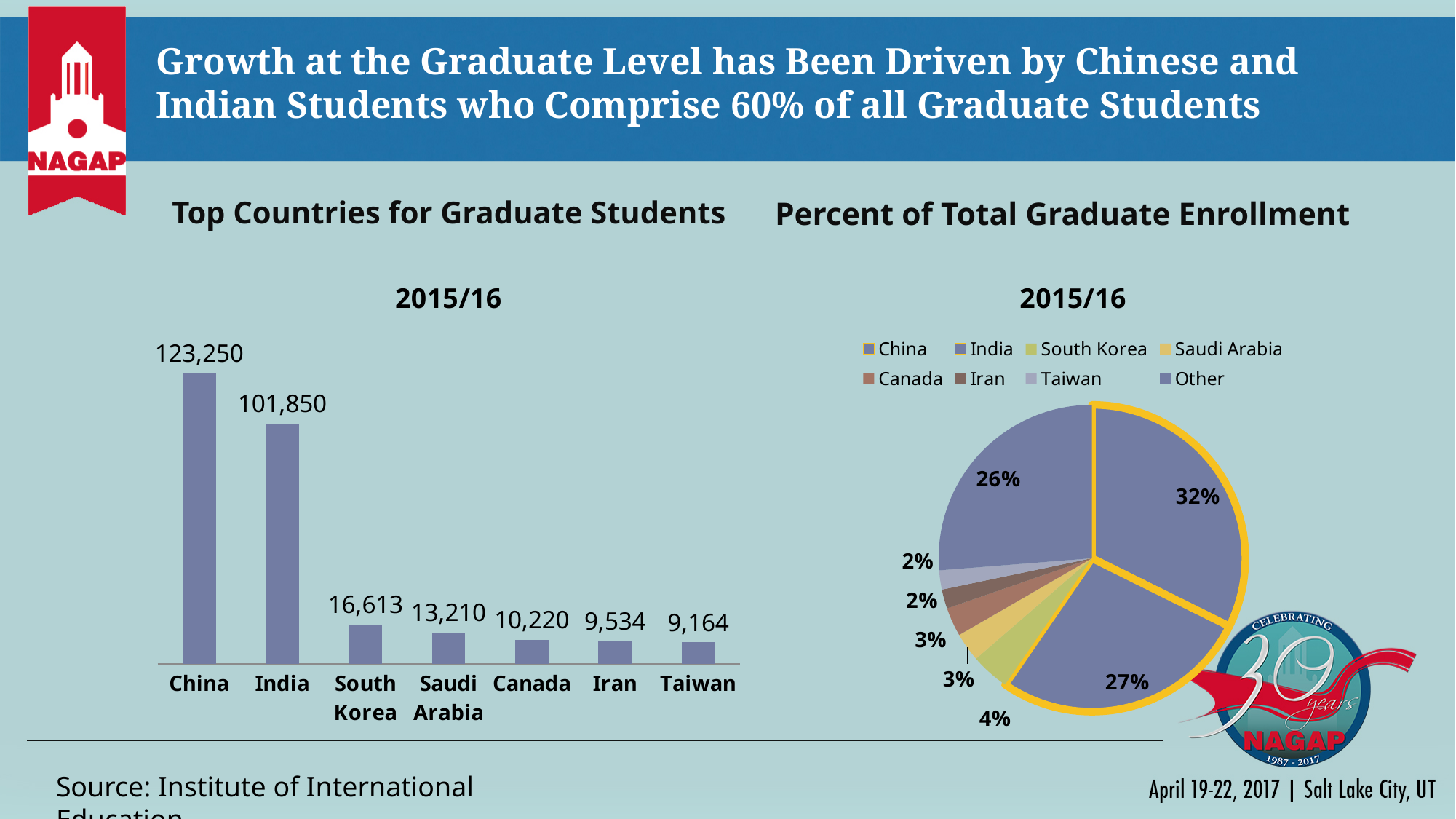
In the bar chart 'Top Countries for Graduate Students', which is larger, the value for Canada or the value for Iran? Canada In the pie chart 'Percent of Total Graduate Enrollment', what share does the 'Other' category have? 26% How many countries are shown in the bar chart 'Top Countries for Graduate Students'? 7 What academic year do both charts on the slide cover? 2015/16 In the pie chart 'Percent of Total Graduate Enrollment', what share does India have? 27% In the bar chart 'Top Countries for Graduate Students', what is the difference between the values for China and India? 21,400 In the pie chart 'Percent of Total Graduate Enrollment', what share does China have? 32% In the bar chart 'Top Countries for Graduate Students', which country has the lowest value? Taiwan In the bar chart 'Top Countries for Graduate Students', what is the value for China? 123,250 What kind of chart is 'Top Countries for Graduate Students'? Bar chart How many entries does the legend of the pie chart 'Percent of Total Graduate Enrollment' list? 8 In the bar chart 'Top Countries for Graduate Students', what is the value for Saudi Arabia? 13,210